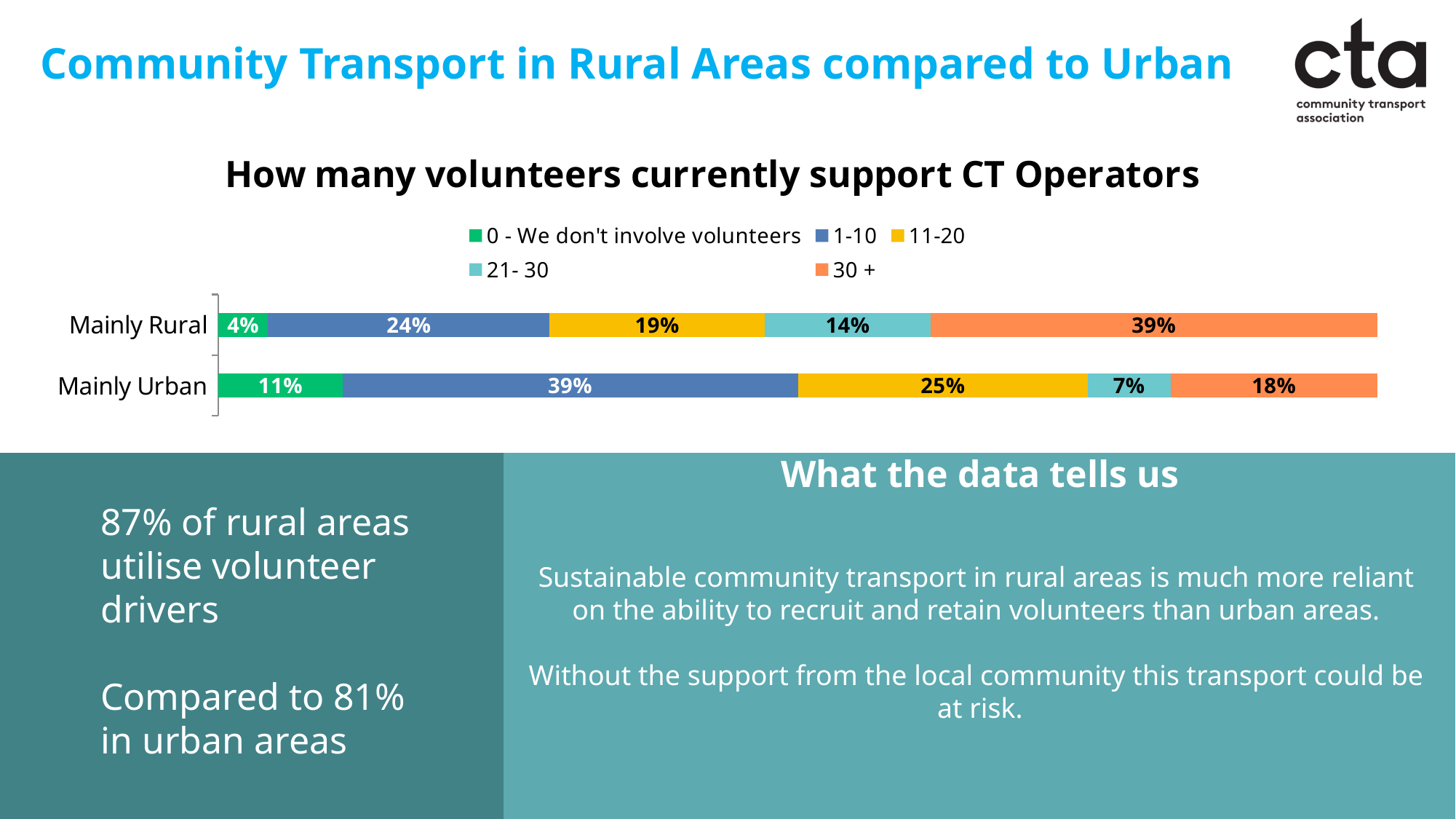
Which volunteer band has the smallest share for Mainly Urban operators? 21- 30 What percentage of Mainly Rural operators have 30 + volunteers? 39% What percentage of Mainly Urban operators have 1-10 volunteers? 39% What is the difference between the 30 + share for Mainly Rural and Mainly Urban? 21 percentage points Which has a larger 11-20 share, Mainly Rural or Mainly Urban? Mainly Urban What is the title of the chart? How many volunteers currently support CT Operators Which volunteer band has the largest share for Mainly Rural operators? 30 + What kind of chart is shown? Stacked bar chart How many series does the legend list? 5 What percentage of Mainly Rural operators have 21- 30 volunteers? 14% How many categories are shown on the chart? 2 What percentage of Mainly Urban operators don't involve volunteers? 11%